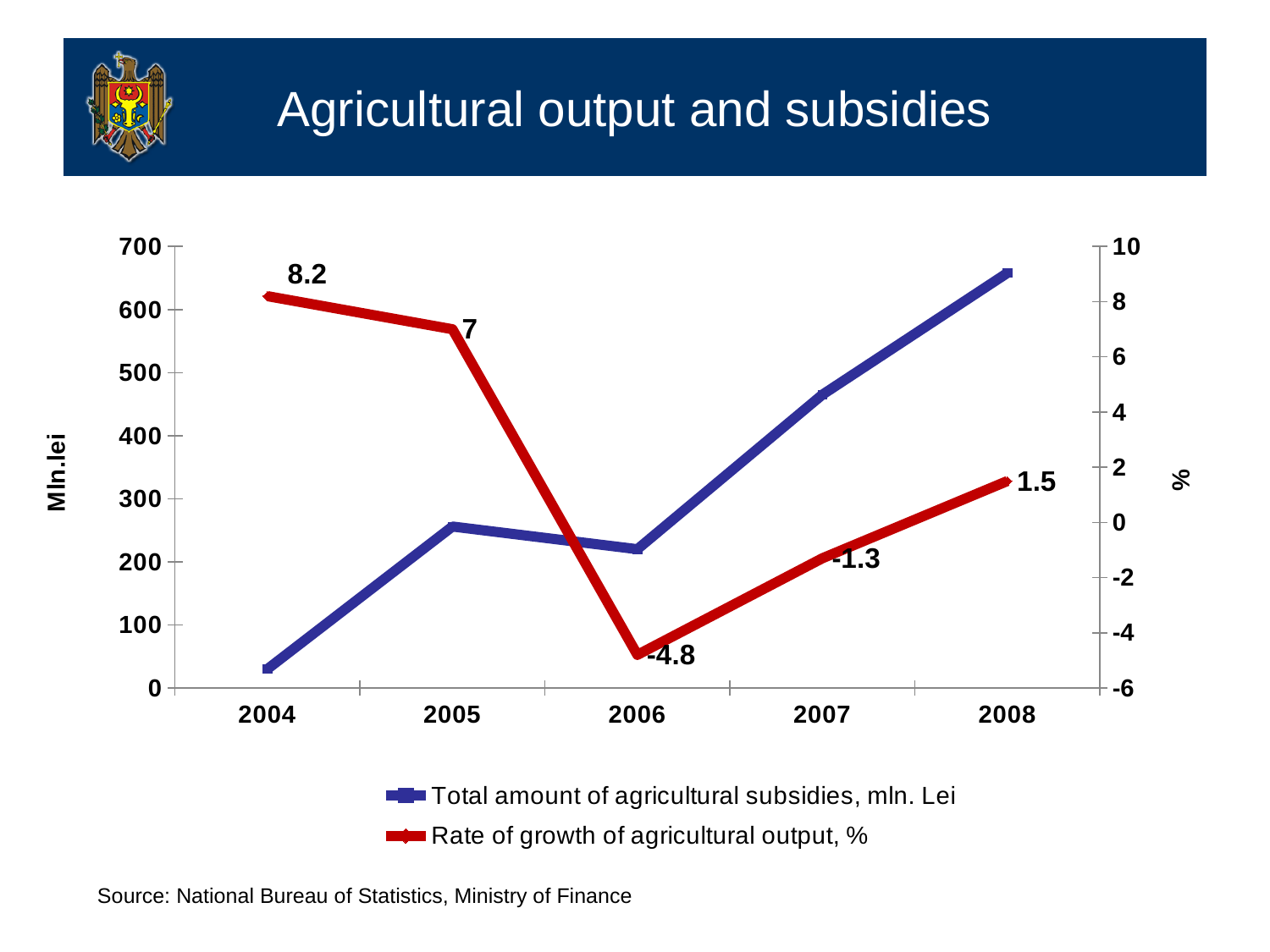
Is the total amount of agricultural subsidies in 2004 greater or less than 100 mln. Lei? less In which year is the rate of growth of agricultural output highest? 2004 What is the difference between the rate of growth of agricultural output in 2004 and in 2005? 1.2 What is the rate of growth of agricultural output in 2008? 1.5 What type of chart is shown on the slide? line chart Is the rate of growth of agricultural output higher in 2007 or in 2008? 2008 Is the total amount of agricultural subsidies in 2008 greater or less than 600 mln. Lei? greater How many years are shown on the x axis? 5 What is the rate of growth of agricultural output in 2004? 8.2 In which year is the rate of growth of agricultural output lowest? 2006 What is the rate of growth of agricultural output in 2006? -4.8 How many series does the legend list? 2